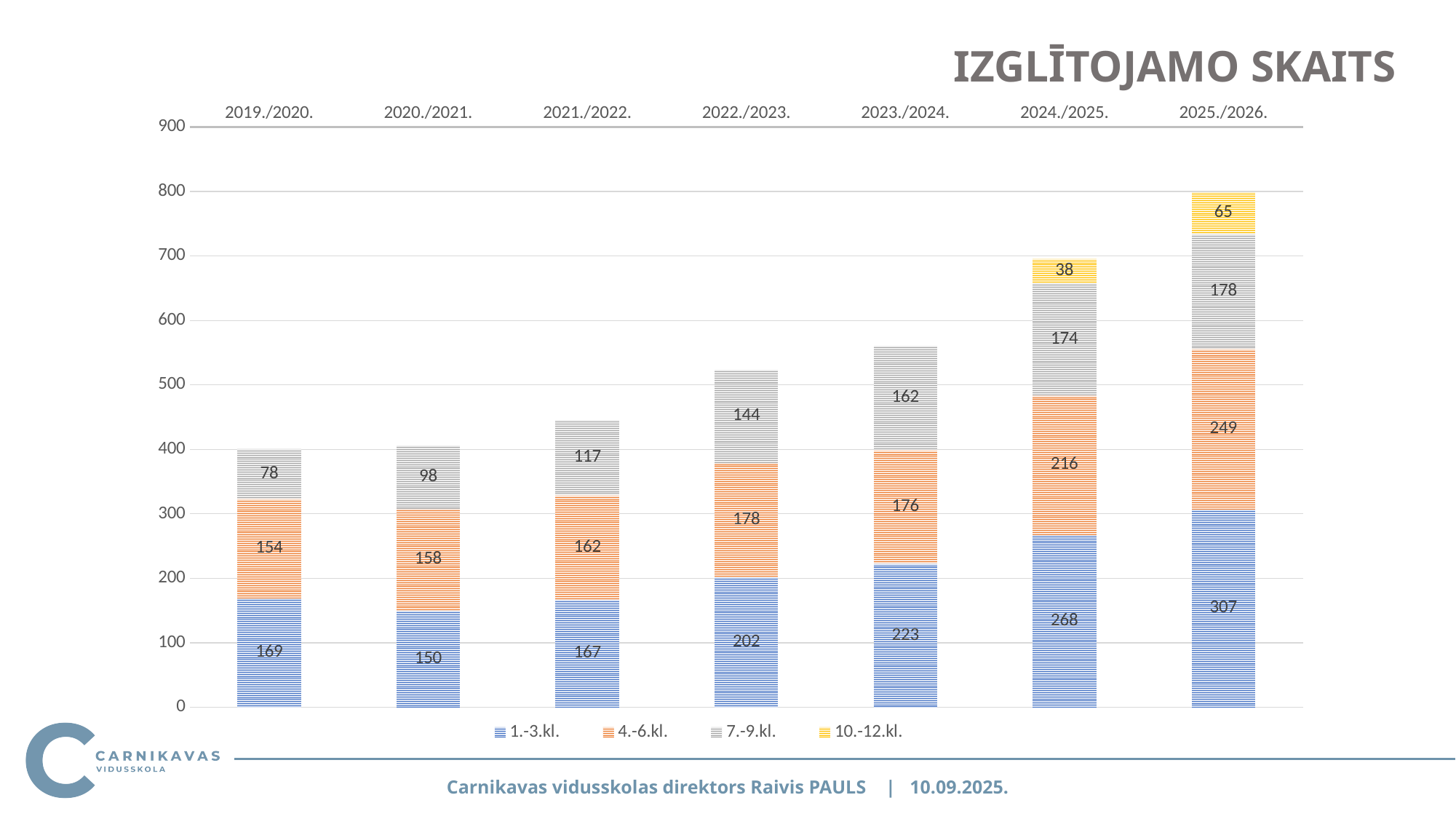
What is the value for 10.-12.kl. in 2024./2025.? 38 What type of chart is shown on the slide? stacked bar chart What is the title of the chart? IZGLĪTOJAMO SKAITS How many school years are shown on the x axis? 7 How many series does the legend list? 4 What is the value for 1.-3.kl. in 2025./2026.? 307 Which school year has the highest value for 4.-6.kl.? 2025./2026. What is the total of the stacked bar for 2024./2025.? 696 Which school year has the lowest value for 1.-3.kl.? 2020./2021. Do the total bar heights rise or fall from 2019./2020. to 2025./2026.? rise What is the value for 7.-9.kl. in 2022./2023.? 144 What is the difference between the 1.-3.kl. values for 2025./2026. and 2024./2025.? 39